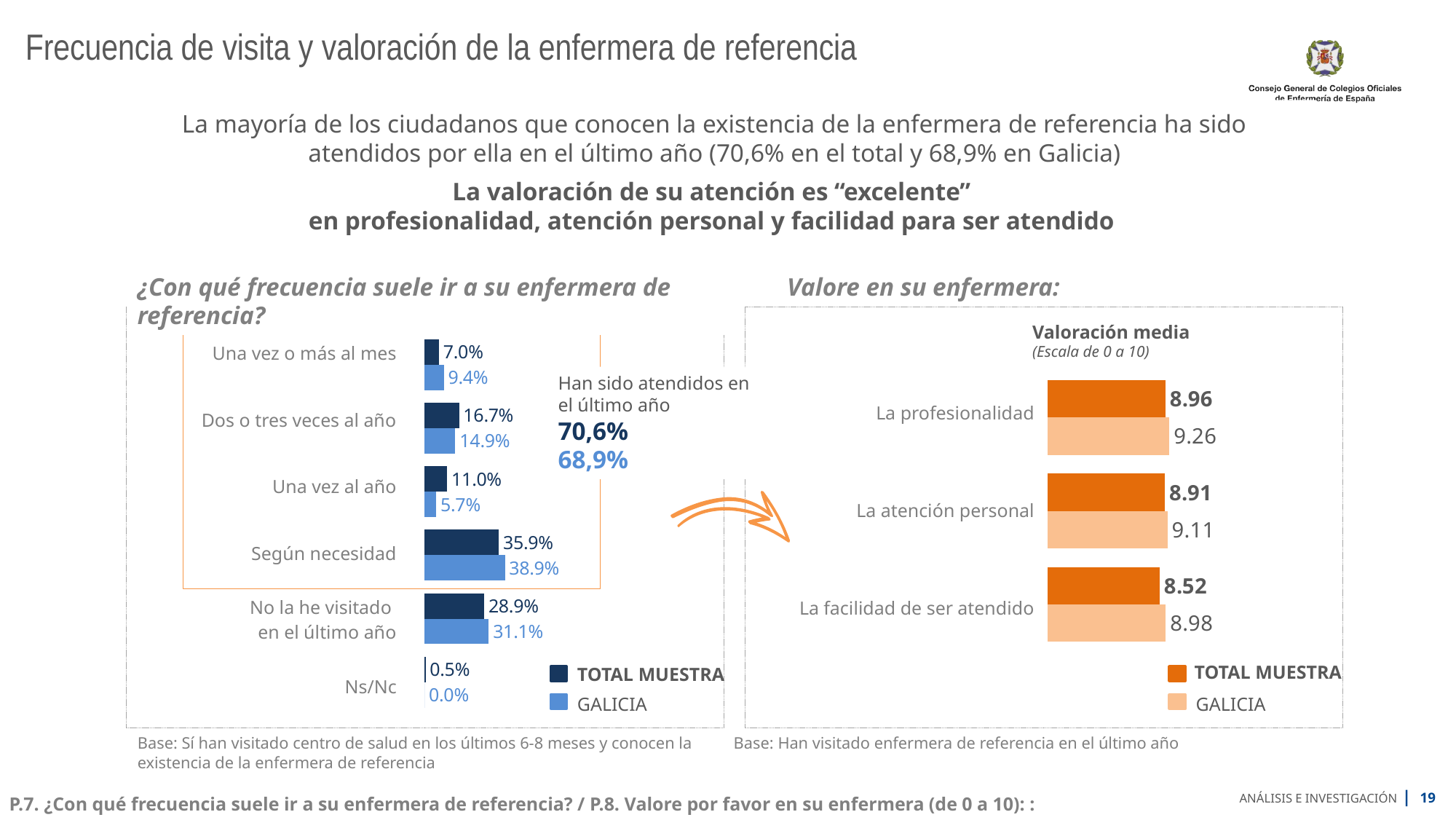
In the left chart (¿Con qué frecuencia suele ir a su enfermera de referencia?), what is the GALICIA value for 'Una vez o más al mes'? 9.4% In the right chart (Valore en su enfermera), what is the difference between the GALICIA and TOTAL MUESTRA values for 'La profesionalidad'? 0.30 In the left chart (¿Con qué frecuencia suele ir a su enfermera de referencia?), which category has the lowest GALICIA value? Ns/Nc How many categories does the left chart (¿Con qué frecuencia suele ir a su enfermera de referencia?) show? 6 What kind of chart is the right chart (Valore en su enfermera)? Bar chart In the left chart (¿Con qué frecuencia suele ir a su enfermera de referencia?), what is the difference between the GALICIA and TOTAL MUESTRA values for 'No la he visitado en el último año'? 2.2% In the right chart (Valore en su enfermera), what is the GALICIA value for 'La atención personal'? 9.11 How many series does the legend of the right chart (Valore en su enfermera) list? 2 In the left chart (¿Con qué frecuencia suele ir a su enfermera de referencia?), what is the TOTAL MUESTRA value for 'Según necesidad'? 35.9% In the left chart (¿Con qué frecuencia suele ir a su enfermera de referencia?), which is larger for 'Una vez al año': TOTAL MUESTRA or GALICIA? TOTAL MUESTRA In the left chart (¿Con qué frecuencia suele ir a su enfermera de referencia?), which category has the highest TOTAL MUESTRA value? Según necesidad In the right chart (Valore en su enfermera), which category has the lowest TOTAL MUESTRA value? La facilidad de ser atendido